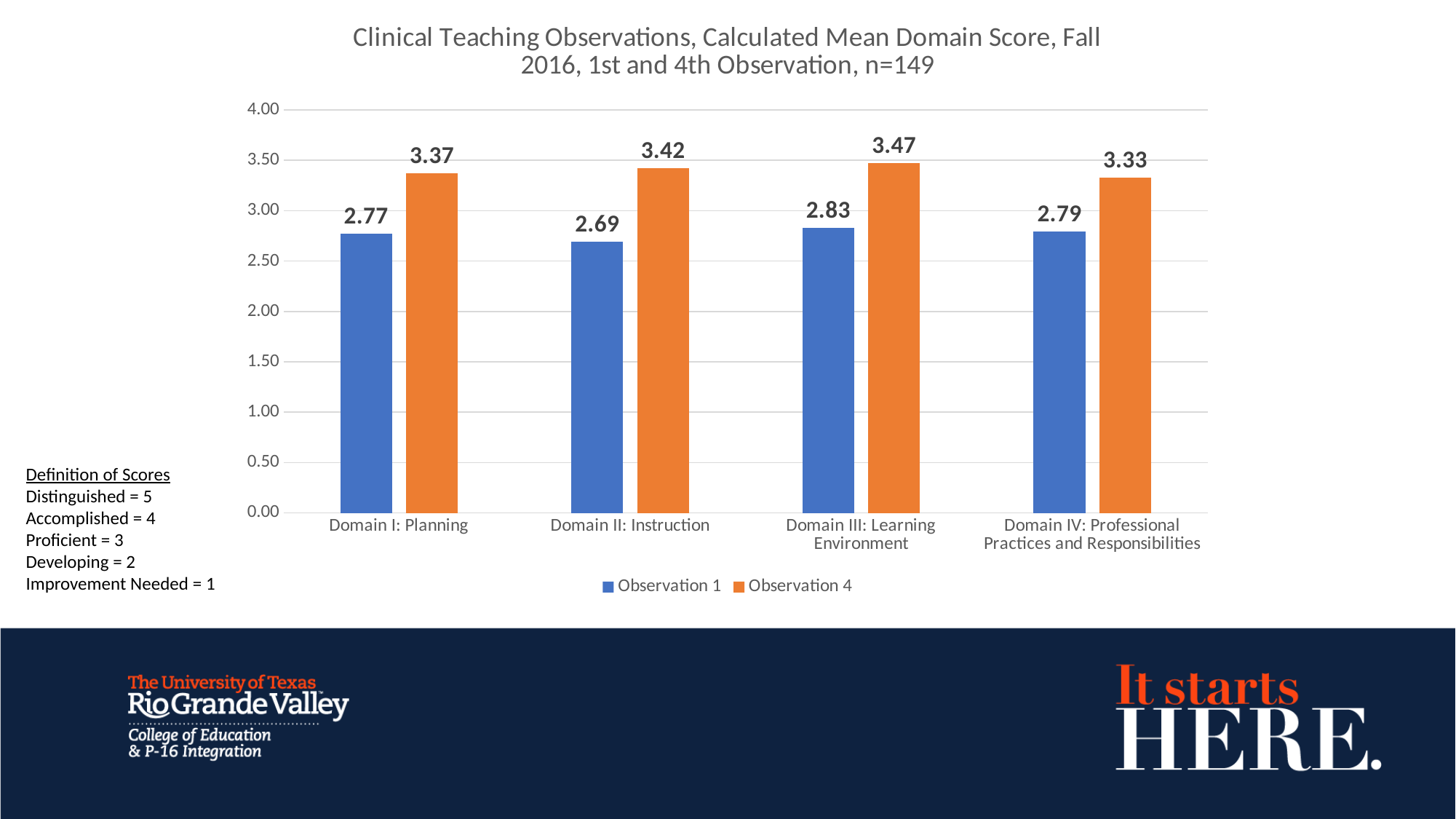
What is the Observation 4 value for Domain III: Learning Environment? 3.47 What is the difference between Observation 4 and Observation 1 for Domain II: Instruction? 0.73 What colour are the Observation 4 bars? orange Is the Observation 4 value for Domain I: Planning greater or less than 3.00? greater Which is larger for Domain IV: Professional Practices and Responsibilities, Observation 1 or Observation 4? Observation 4 What is the Observation 1 value for Domain II: Instruction? 2.69 How many domains are shown on the x axis? 4 What is the Observation 1 value for Domain I: Planning? 2.77 Which domain has the highest Observation 4 value? Domain III: Learning Environment What kind of chart is shown on the slide? bar chart How many series does the legend list? 2 Which domain has the lowest Observation 1 value? Domain II: Instruction